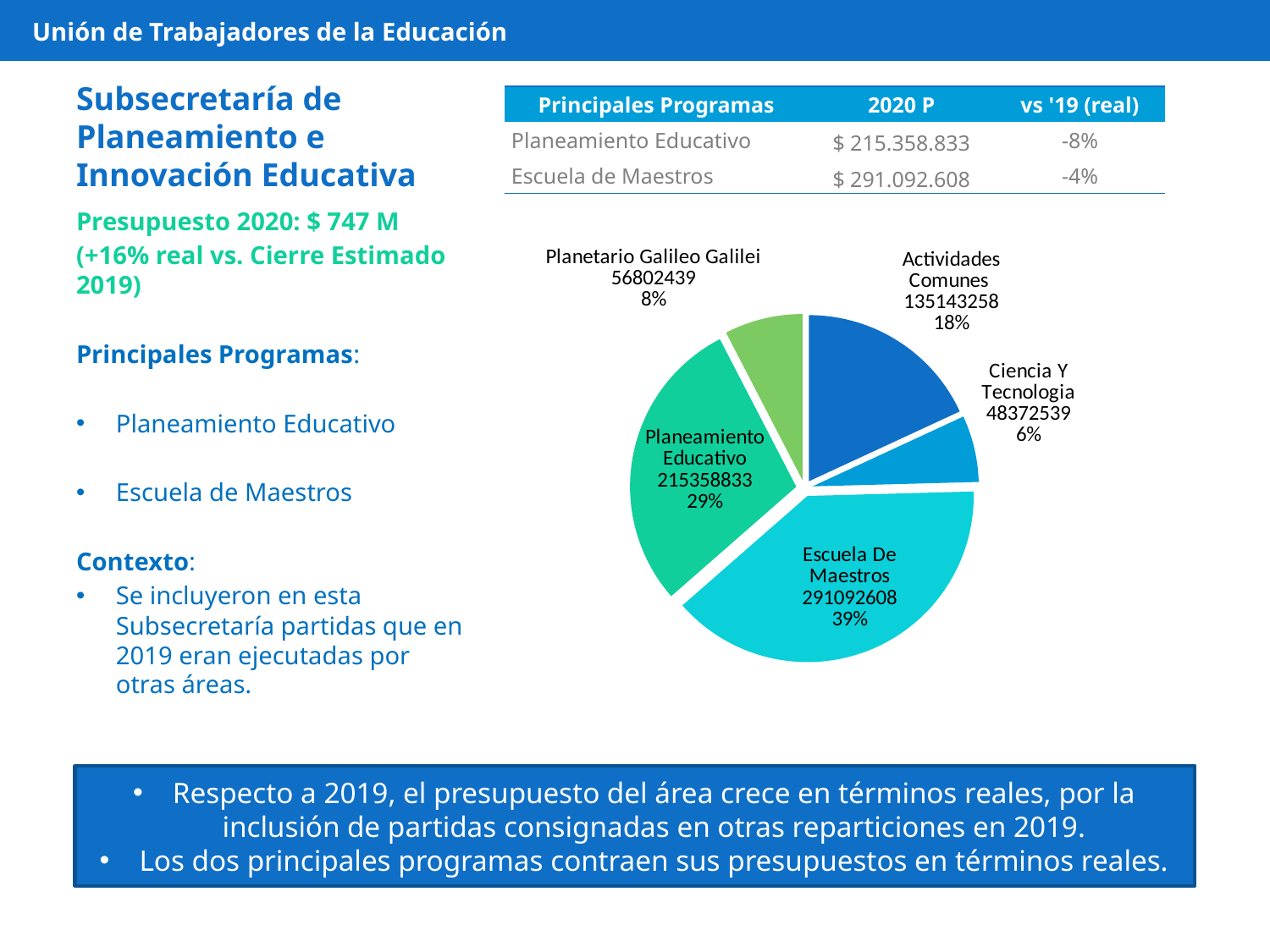
What percentage share of the pie does Ciencia Y Tecnologia represent? 6% What is the value shown for Planeamiento Educativo in the pie chart? 215358833 What is the value shown for Actividades Comunes in the pie chart? 135143258 What kind of chart is shown on the slide? pie chart What is the value shown for Planetario Galileo Galilei in the pie chart? 56802439 Which slice of the pie chart is the smallest? Ciencia Y Tecnologia What percentage share of the pie does Escuela De Maestros represent? 39% What is the value shown for Escuela De Maestros in the pie chart? 291092608 Which is larger in the pie chart, Actividades Comunes or Planetario Galileo Galilei? Actividades Comunes Which slice of the pie chart is the largest? Escuela De Maestros What is the difference between the values for Escuela De Maestros and Planeamiento Educativo in the pie chart? 75733775 How many slices does the pie chart have? 5